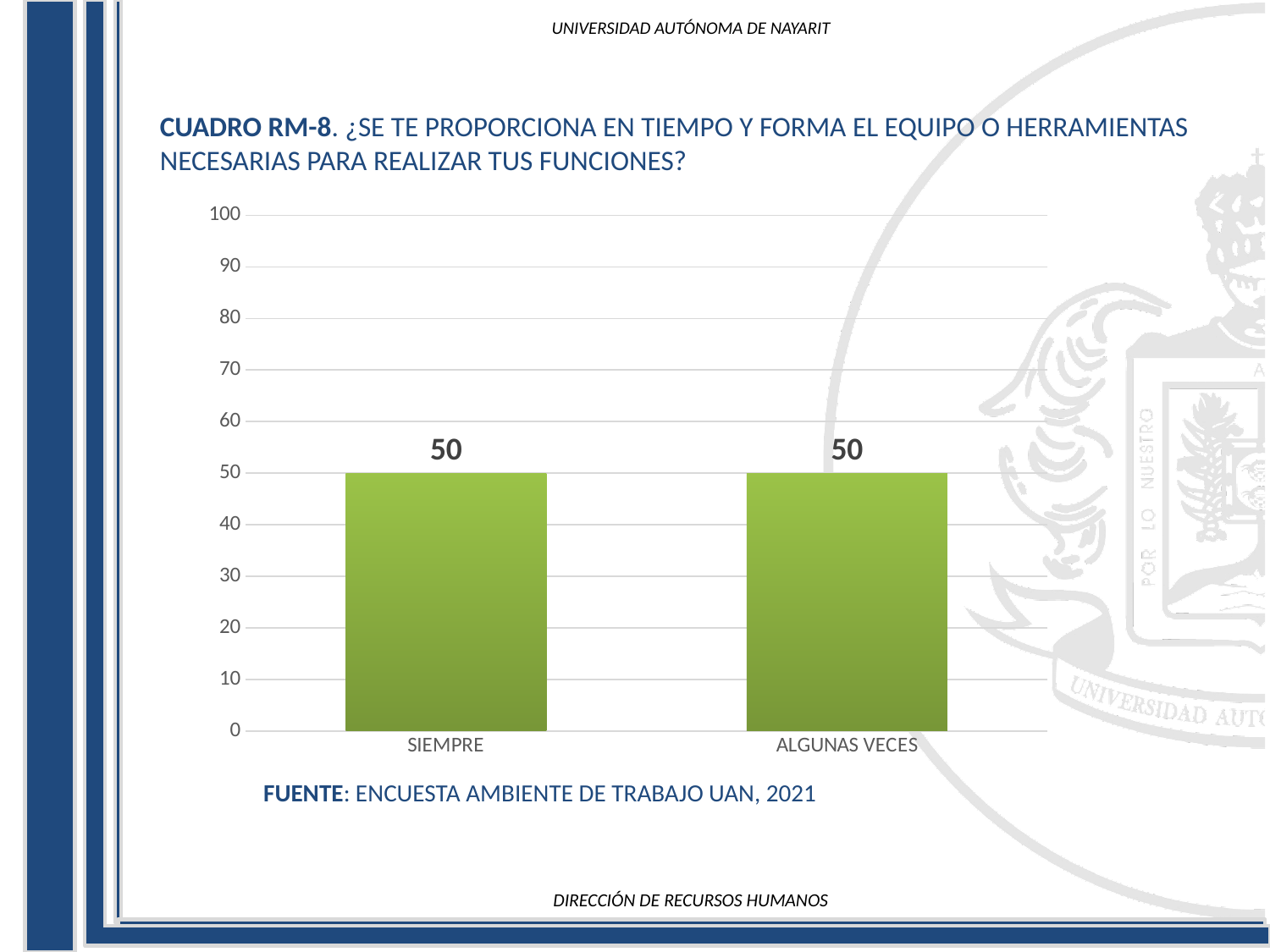
What is the value for ALGUNAS VECES? 50 What source is cited below the chart? ENCUESTA AMBIENTE DE TRABAJO UAN, 2021 What is the total of the values for SIEMPRE and ALGUNAS VECES? 100 Is the value for SIEMPRE greater or less than 60? less What is the value for SIEMPRE? 50 What is the highest value shown on the y axis? 100 What is the difference between the values for SIEMPRE and ALGUNAS VECES? 0 What kind of chart is shown on the slide? bar chart How many categories are shown on the x axis? 2 Is the value for ALGUNAS VECES greater or less than 40? greater Do the values rise, fall or stay the same from SIEMPRE to ALGUNAS VECES? stay the same